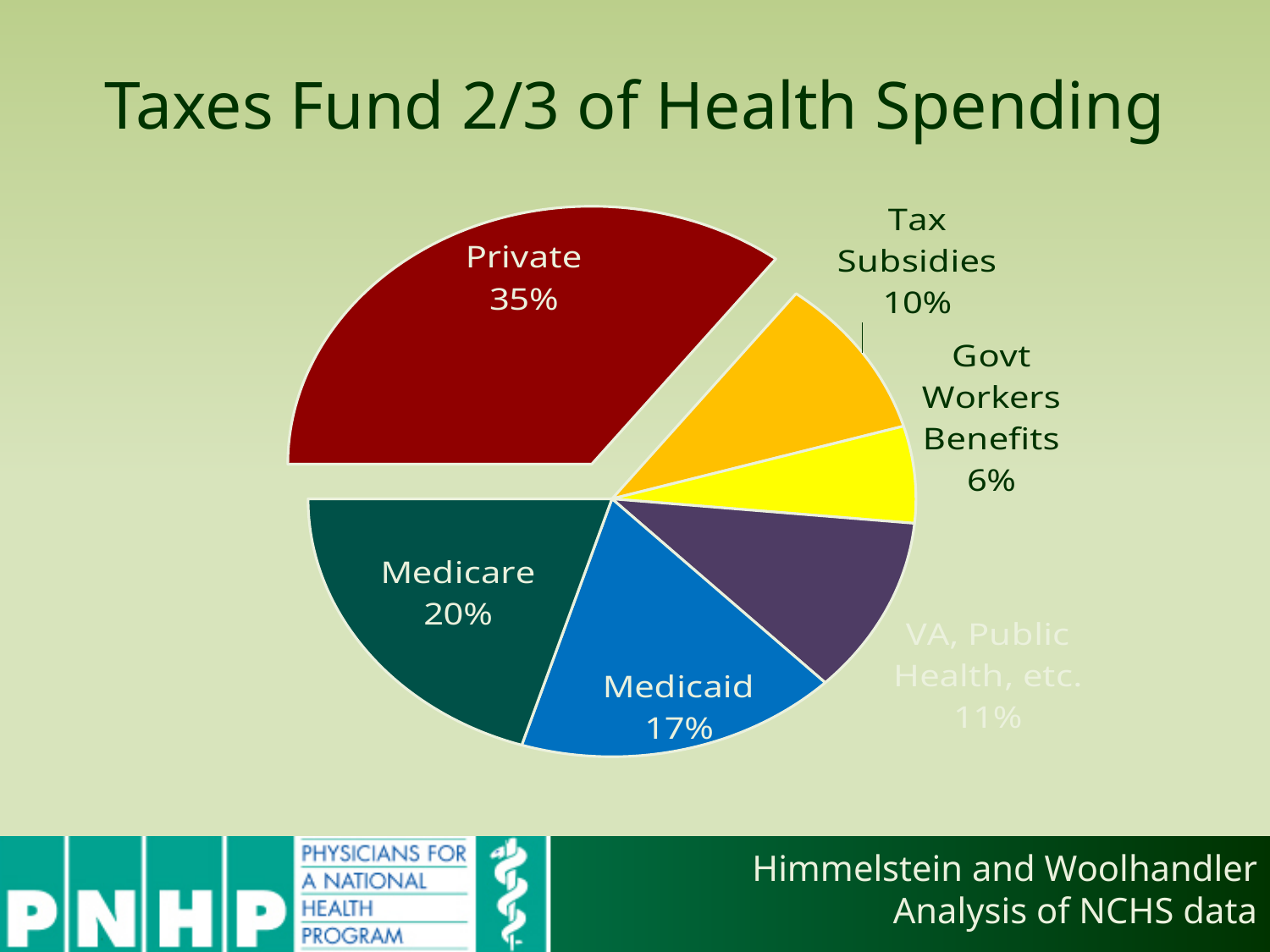
What is the title of the slide containing the pie chart? Taxes Fund 2/3 of Health Spending Which is larger, Medicare or Medicaid? Medicare How many slices does the pie chart have? 6 Which slice of the pie is the smallest? Govt Workers Benefits What percentage is shown for Tax Subsidies? 10% What share of health spending does the Private slice represent? 35% What percentage is shown for Govt Workers Benefits? 6% What percentage is shown for Medicaid? 17% What percentage is shown for Medicare? 20% What is the difference in percentage points between Private and Medicare? 15 What kind of chart is shown on the slide? pie chart Which slice of the pie is the largest? Private